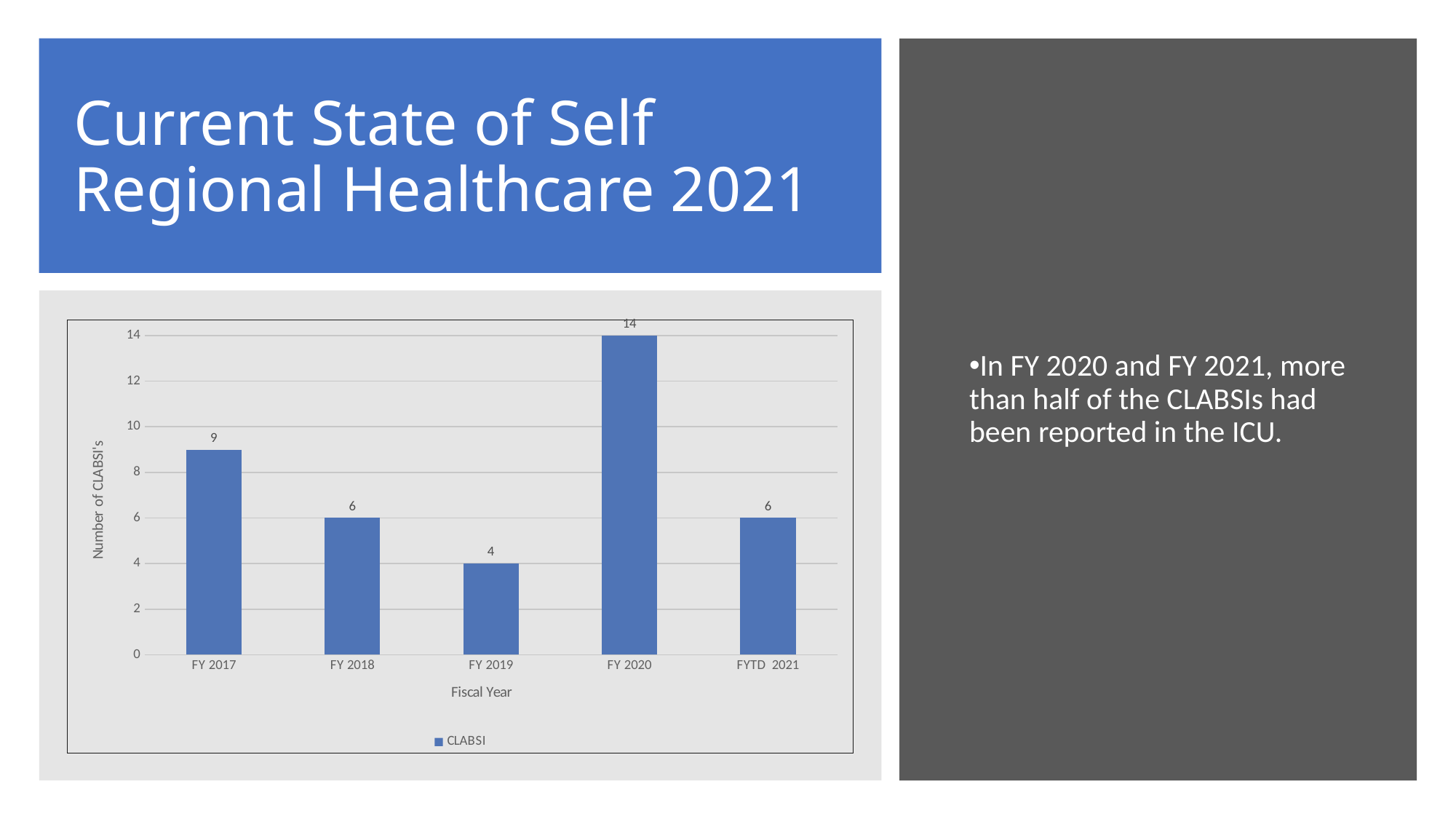
What is the number of CLABSI's for FYTD 2021? 6 What is the number of CLABSI's for FY 2020? 14 What is the difference in the number of CLABSI's between FY 2017 and FY 2018? 3 What kind of chart is shown on the slide? Bar chart What is the difference in the number of CLABSI's between FY 2020 and FY 2019? 10 How many fiscal years are shown on the x axis of the chart? 5 What is the number of CLABSI's for FY 2017? 9 Which fiscal year has the highest number of CLABSI's? FY 2020 Which fiscal year has the lowest number of CLABSI's? FY 2019 Which has more CLABSI's, FY 2017 or FY 2018? FY 2017 Is the value for FY 2020 greater or less than 12? greater How many series does the chart legend list? 1